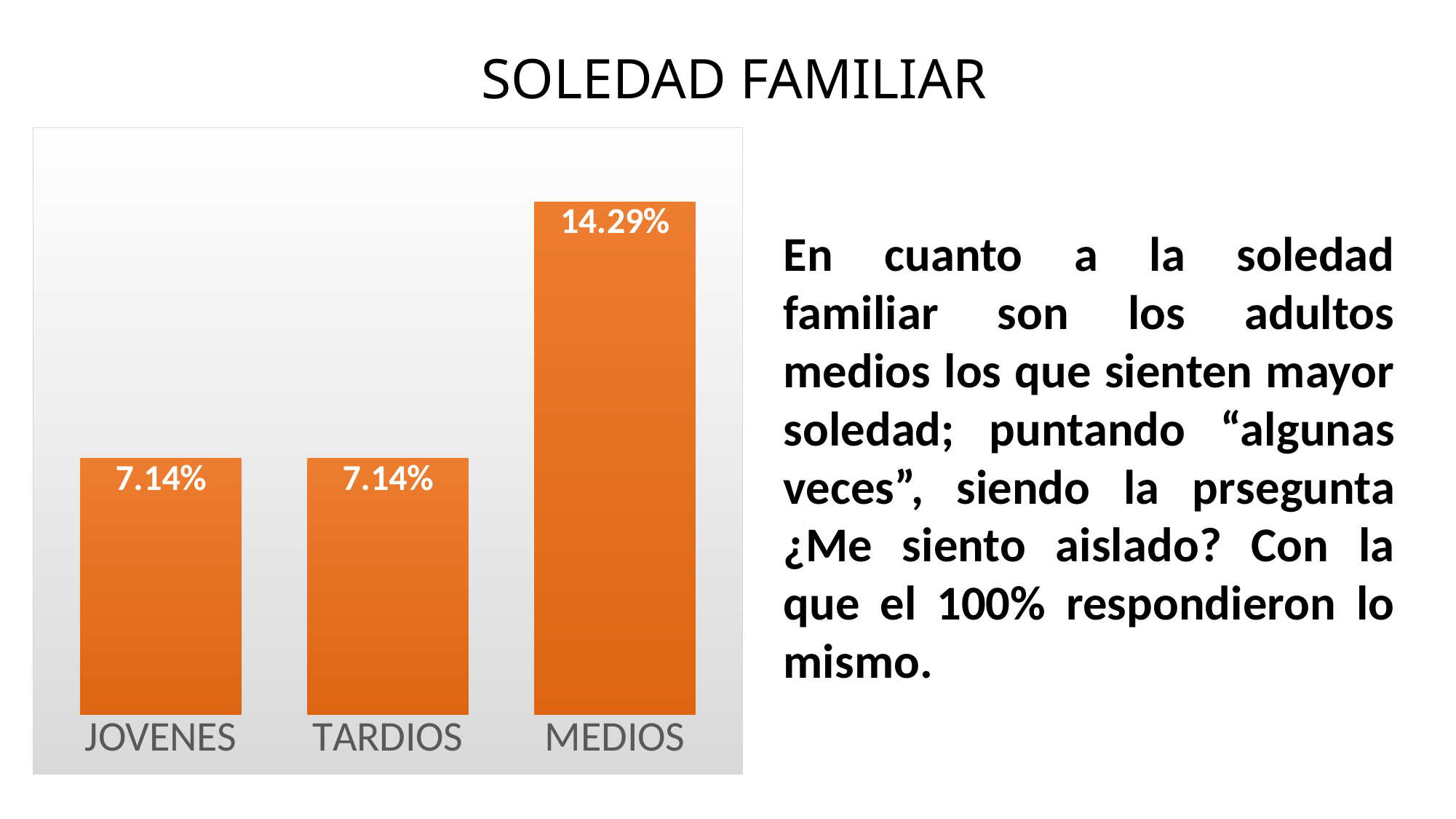
What is the title of the slide? SOLEDAD FAMILIAR How many categories are shown in the chart? 3 Which category has the highest value? MEDIOS What is the value for JOVENES? 7.14% Which is larger, the value for MEDIOS or the value for TARDIOS? MEDIOS What kind of chart is shown on the slide? bar chart What is the value for TARDIOS? 7.14% Do the values for JOVENES and TARDIOS differ? No, both are 7.14% What colour are the bars in the chart? orange What is the difference between the values for MEDIOS and JOVENES? 7.15% What is the value for MEDIOS? 14.29%